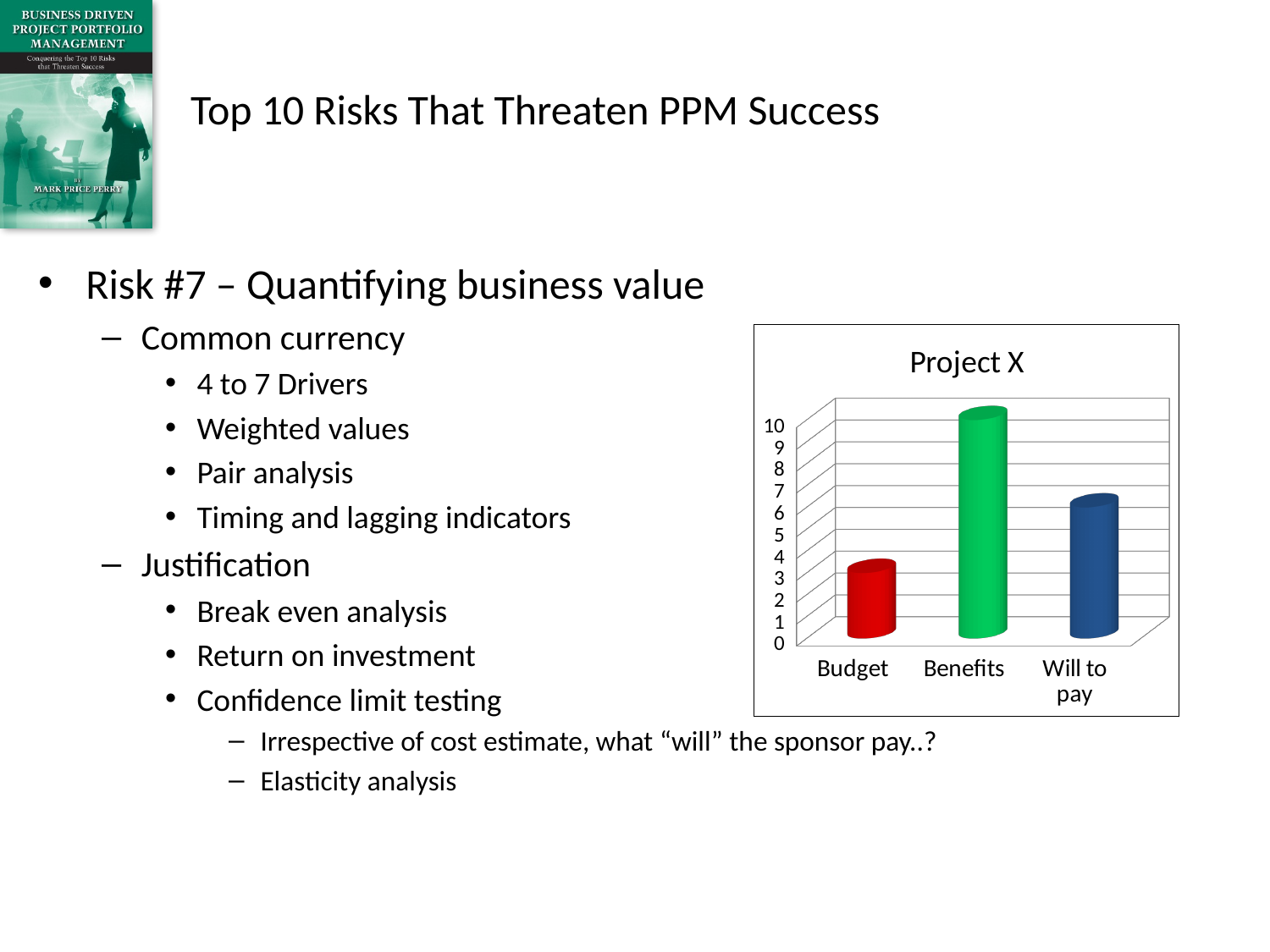
Which is larger, the value for Budget or the value for Will to pay? Will to pay What kind of chart is shown on the slide? bar chart What colour is the bar for Benefits? green Is the value for Benefits greater or less than 8? greater Is the value for Will to pay greater or less than 8? less Is the value for Will to pay greater or less than 4? greater Which category has the highest value in the chart? Benefits How many categories are shown on the x axis of the chart? 3 What is the title of the chart? Project X Which category has the lowest value in the chart? Budget Which is larger, the value for Benefits or the value for Will to pay? Benefits